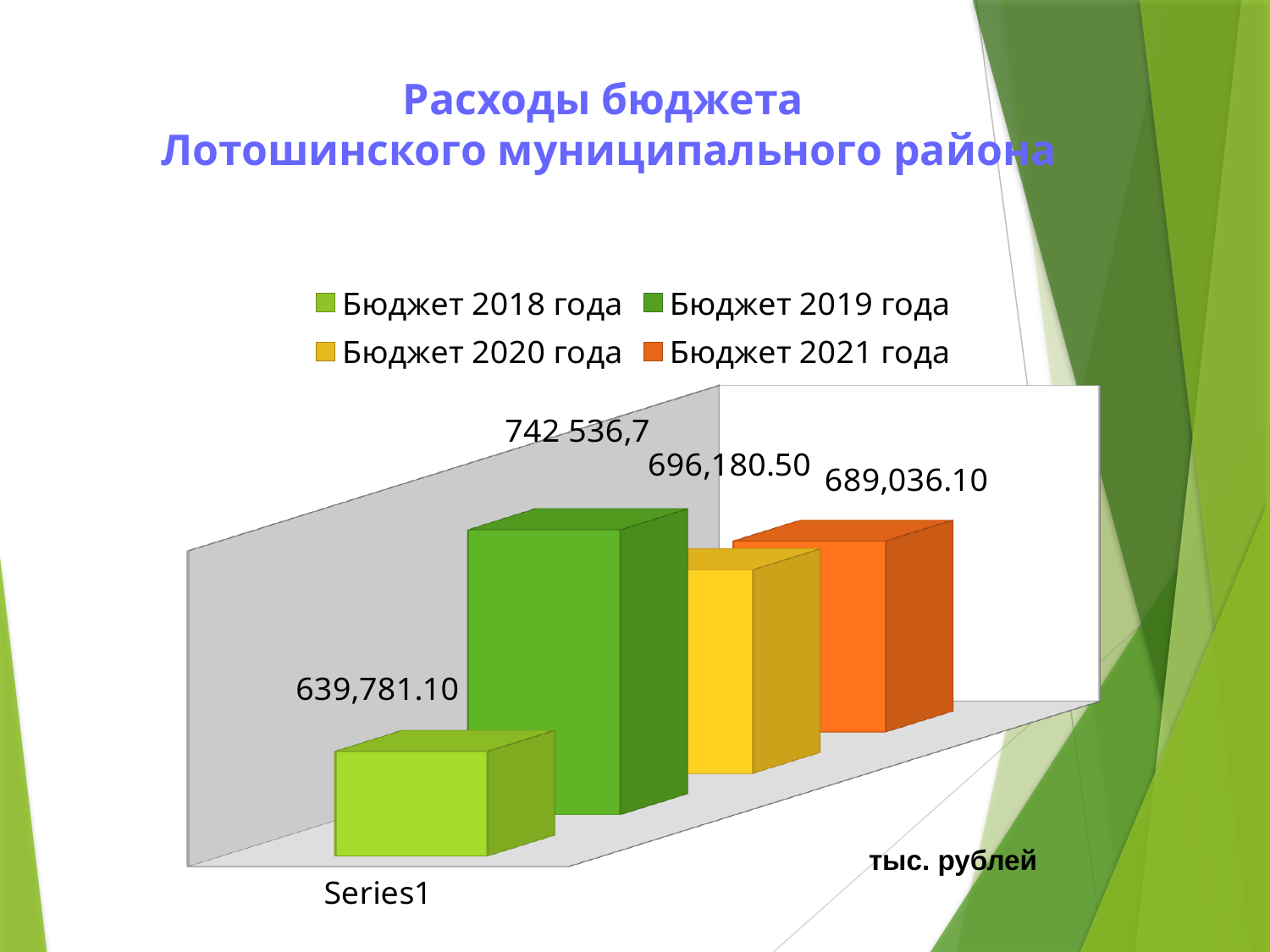
What unit is indicated for the values in the chart? тыс. рублей What is the difference between the values for Бюджет 2021 года and Бюджет 2018 года? 49,255.00 What is the difference between the values for Бюджет 2020 года and Бюджет 2021 года? 7,144.40 What is the value for Бюджет 2018 года? 639,781.10 Which series has the highest value? Бюджет 2019 года How many series does the legend list? 4 What is the value for Бюджет 2019 года? 742 536,7 Which series has the lowest value? Бюджет 2018 года What is the value for Бюджет 2020 года? 696,180.50 What is the value for Бюджет 2021 года? 689,036.10 Which is larger, the value for Бюджет 2020 года or Бюджет 2021 года? Бюджет 2020 года What kind of chart is shown on the slide? Bar chart